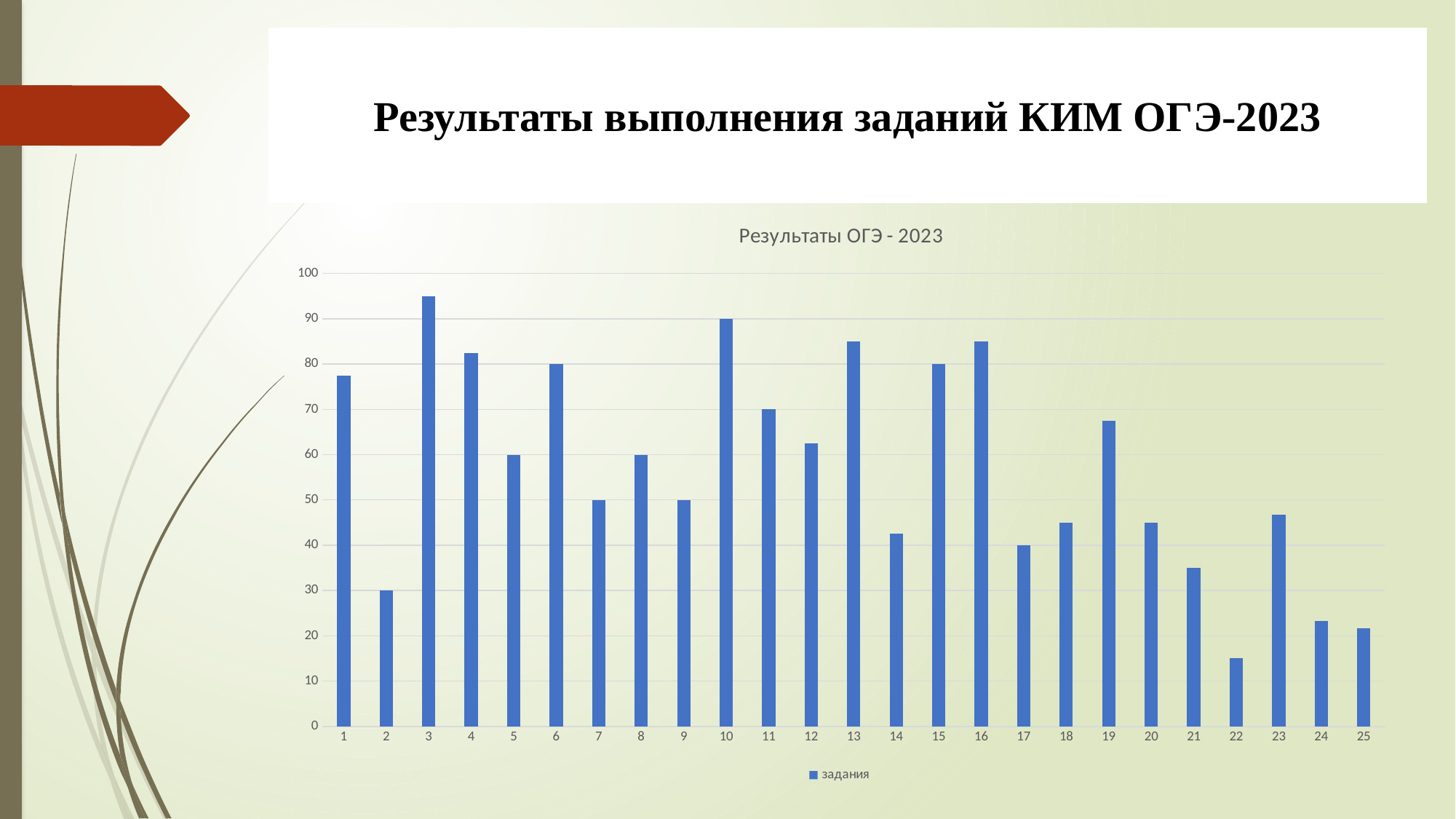
How many series does the legend list? 1 What is the title of the chart? Результаты ОГЭ - 2023 Is the value for task 21 greater or less than 40? less Is the value for task 1 greater or less than 70? greater How many categories (tasks) are shown on the x axis? 25 Is the value for task 19 greater or less than 70? less Which is larger, the value for task 11 or the value for task 12? task 11 Which task has the lowest value? 22 Which is larger, the value for task 3 or the value for task 10? task 3 Which task has the highest value? 3 What kind of chart is shown on the slide? bar chart